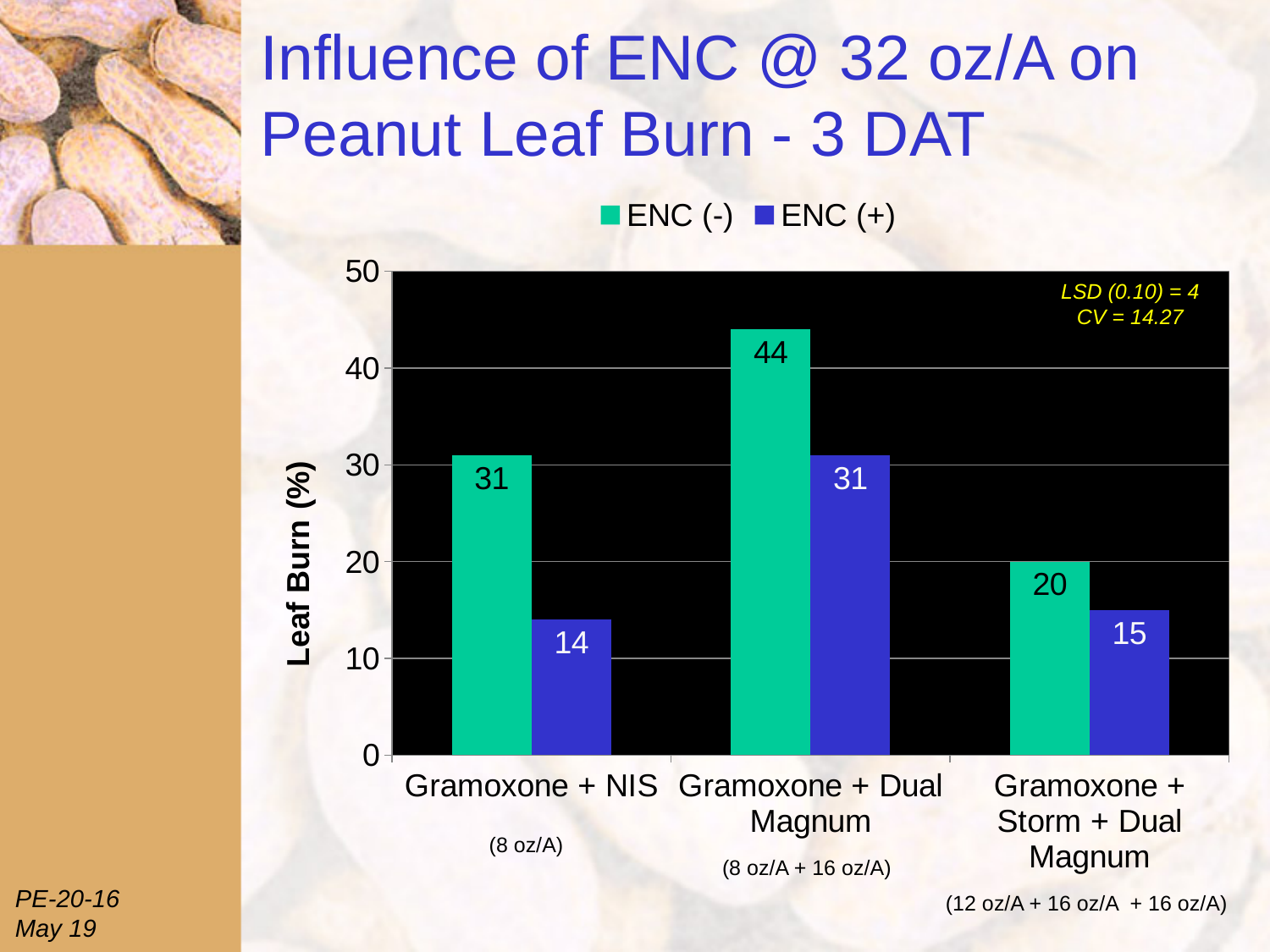
What is the difference between the ENC (-) and ENC (+) values for Gramoxone + NIS? 17 Which treatment has the highest ENC (-) leaf burn? Gramoxone + Dual Magnum How many treatment categories are shown on the x axis? 3 What kind of chart is shown on the slide? Bar chart What is the ENC (-) leaf burn value for Gramoxone + Dual Magnum? 44 Which treatment has the lowest ENC (+) leaf burn? Gramoxone + NIS How many series does the legend list? 2 What is the ENC (+) leaf burn value for Gramoxone + Storm + Dual Magnum? 15 What is the label of the y axis? Leaf Burn (%) Which is larger: the ENC (-) value for Gramoxone + Storm + Dual Magnum or the ENC (+) value for Gramoxone + Dual Magnum? ENC (+) value for Gramoxone + Dual Magnum What is the difference between the ENC (-) and ENC (+) values for Gramoxone + Dual Magnum? 13 What is the ENC (+) leaf burn value for Gramoxone + NIS? 14